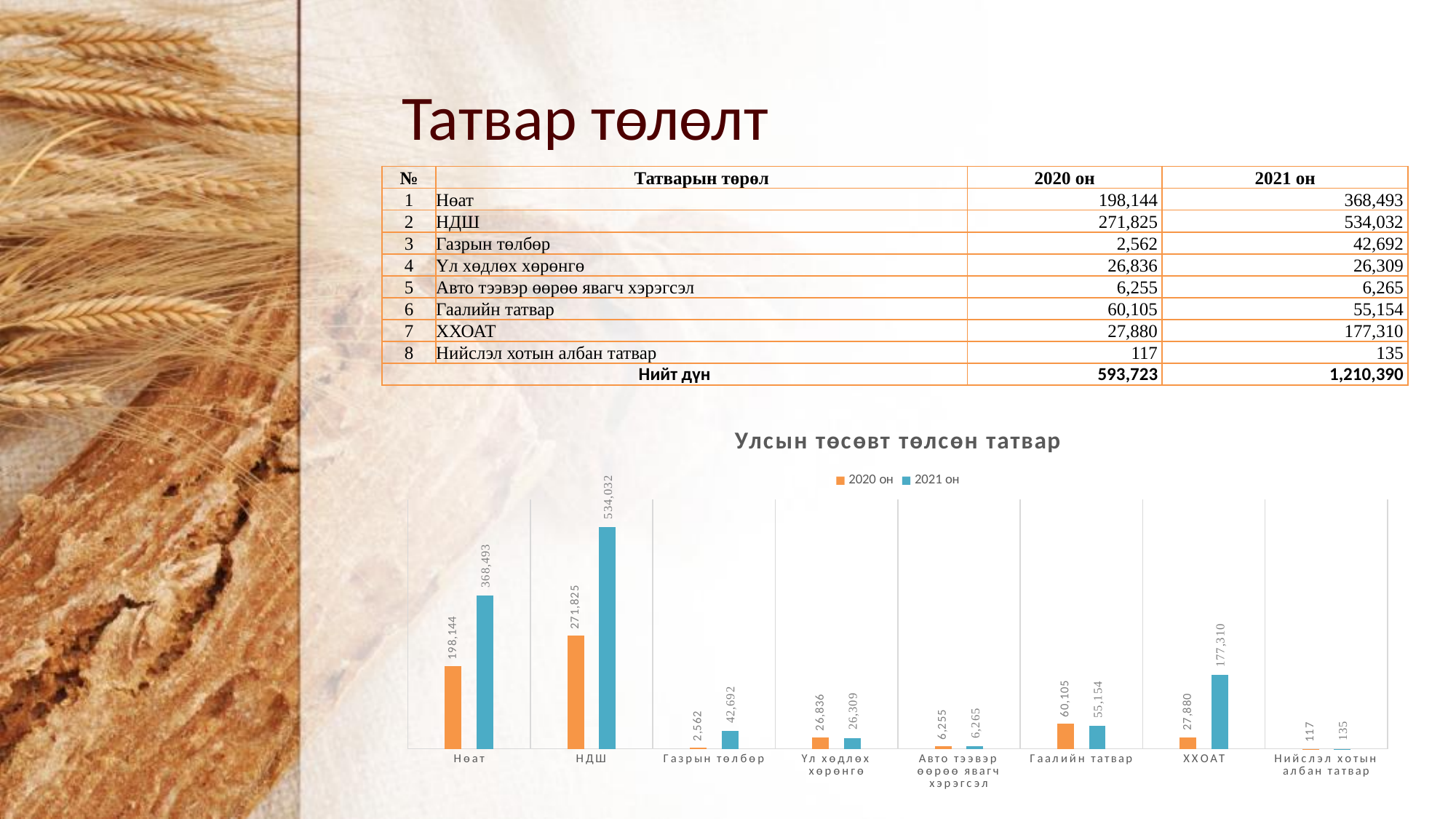
What is the 2021 он value for ХХОАТ in the chart? 177,310 Which category has the lowest 2020 он value in the chart? Нийслэл хотын албан татвар How many series does the chart legend list? 2 Which category has the highest 2021 он value in the chart? НДШ Which series is shown in orange in the chart? 2020 он For Гаалийн татвар, which is larger in the chart: the 2020 он value or the 2021 он value? 2020 он What is the 2021 он value for НДШ in the chart? 534,032 How many categories are shown on the x axis of the chart? 8 What is the 2020 он value for Гаалийн татвар in the chart? 60,105 What is the title of the chart? Улсын төсөвт төлсөн татвар What kind of chart is shown on the slide? Bar chart What is the difference between the 2021 он and 2020 он values for Нөат in the chart? 170,349